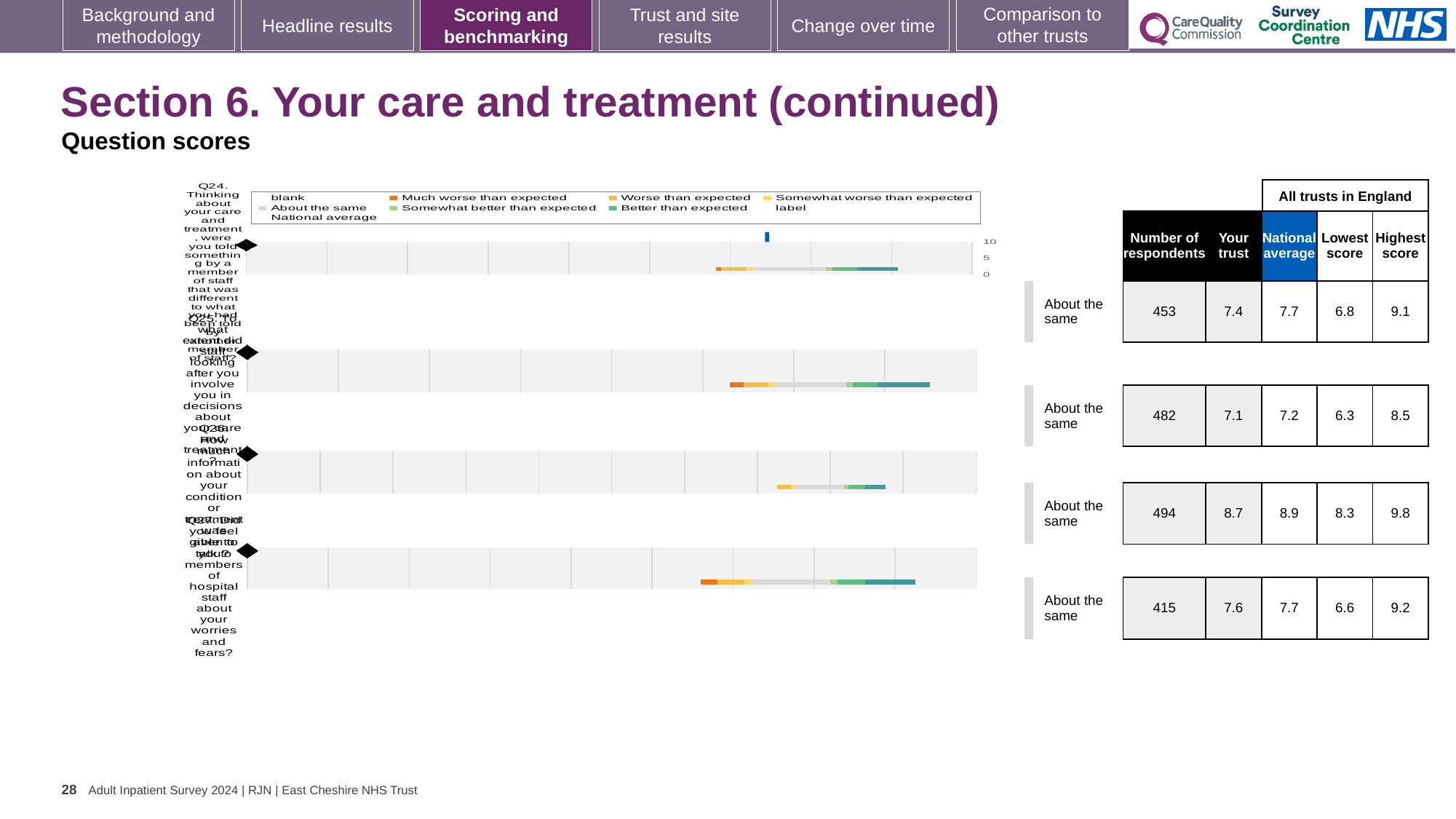
How many questions (bars) are plotted in the chart? 4 What is the national average score for Q24? 7.7 Which question has the lowest 'Your trust' score? Q25 What type of chart is used to show the question scores on this slide? bar chart What is the lowest score among all trusts in England for Q25? 6.3 What benchmark category is shown for all four questions on this slide? About the same For Q26, how much lower is the 'Your trust' score than the national average? 0.2 Which question has the highest 'Your trust' score? Q26 For Q24, which is larger: the 'Your trust' score or the national average? National average What is the 'Your trust' score for Q26 (How much information about your condition or treatment was given to you)? 8.7 How many respondents answered Q27? 415 For Q26, what is the difference between the highest score and the lowest score among all trusts in England? 1.5